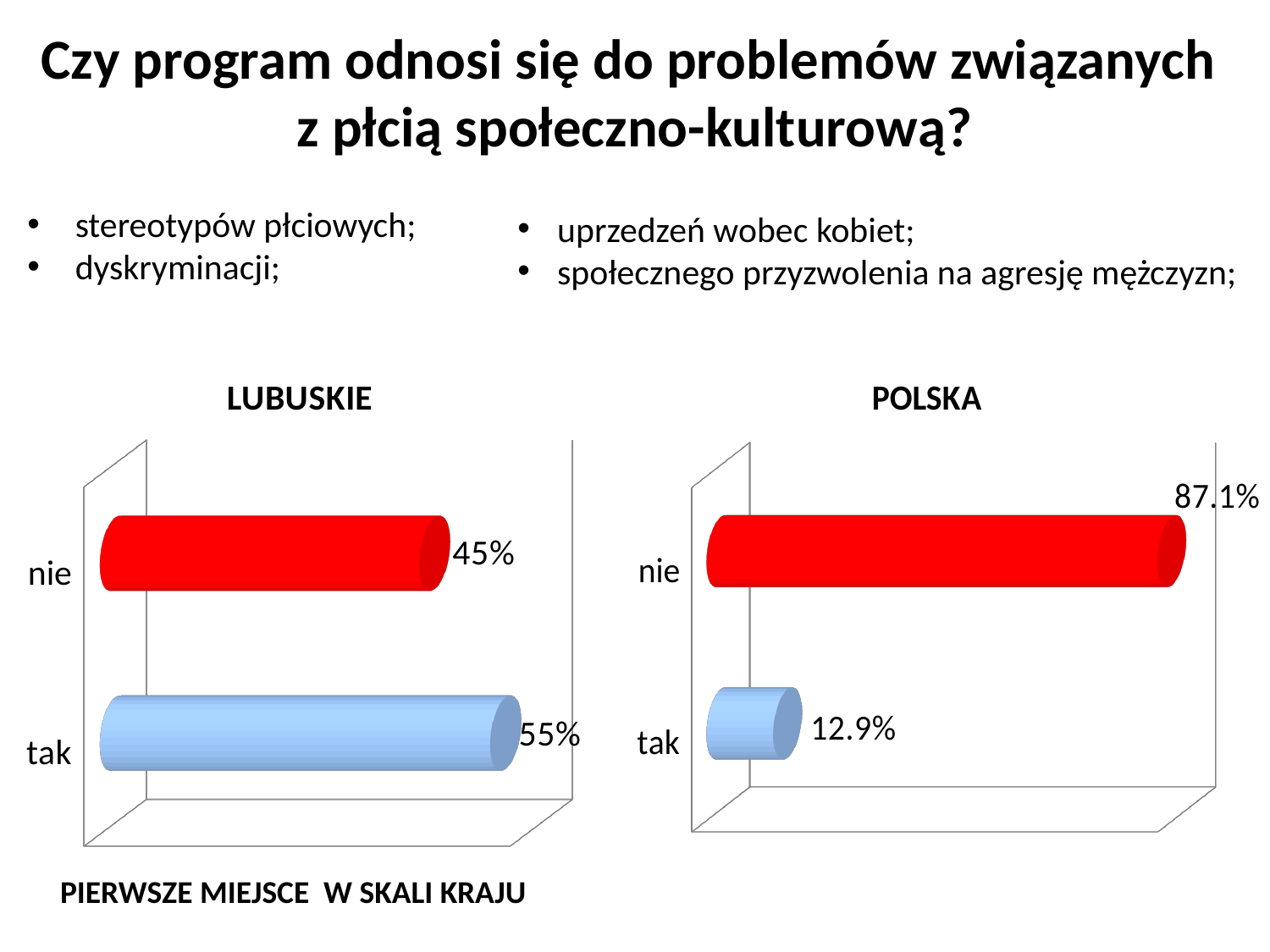
What kind of chart is the LUBUSKIE chart? bar chart In the POLSKA chart, which category has the lowest value? tak How many categories does the POLSKA chart show? 2 In the LUBUSKIE chart, which category has the higher value? tak Is the value for "tak" larger in the LUBUSKIE chart or in the POLSKA chart? LUBUSKIE In the LUBUSKIE chart, what is the difference between the values for "tak" and "nie"? 10% In the POLSKA chart, what is the value for "nie"? 87.1% In the LUBUSKIE chart, what is the value for "nie"? 45% In the POLSKA chart, what is the difference between the values for "nie" and "tak"? 74.2% In the POLSKA chart, what colour is the bar for "nie"? red In the LUBUSKIE chart, what is the value for "tak"? 55% In the POLSKA chart, what is the value for "tak"? 12.9%